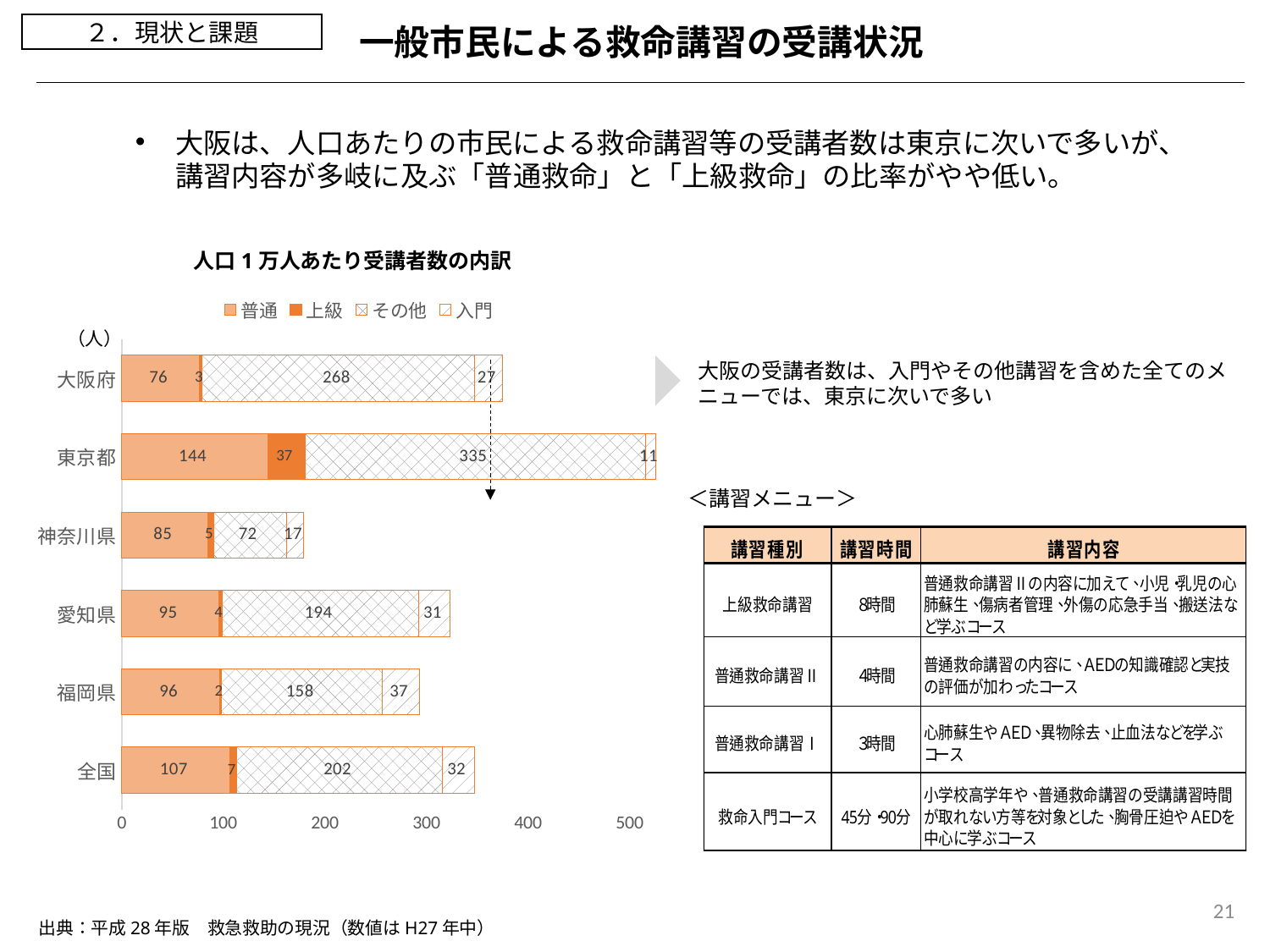
What is the 普通 value for 東京都? 144 What is the title of the chart? 人口１万人あたり受講者数の内訳 Which category has the highest 上級 value? 東京都 How many prefectures/categories are plotted in the chart? 6 Which category has the lowest その他 value? 神奈川県 What is the 入門 value for 福岡県? 37 What type of chart is shown on the slide? Stacked bar chart Which is larger, the 入門 value for 愛知県 or for 全国? 全国 What is the total of the stacked bar for 神奈川県? 179 How many series does the chart legend list? 4 What is the その他 value for 大阪府? 268 What is the difference between the 普通 values for 東京都 and 大阪府? 68